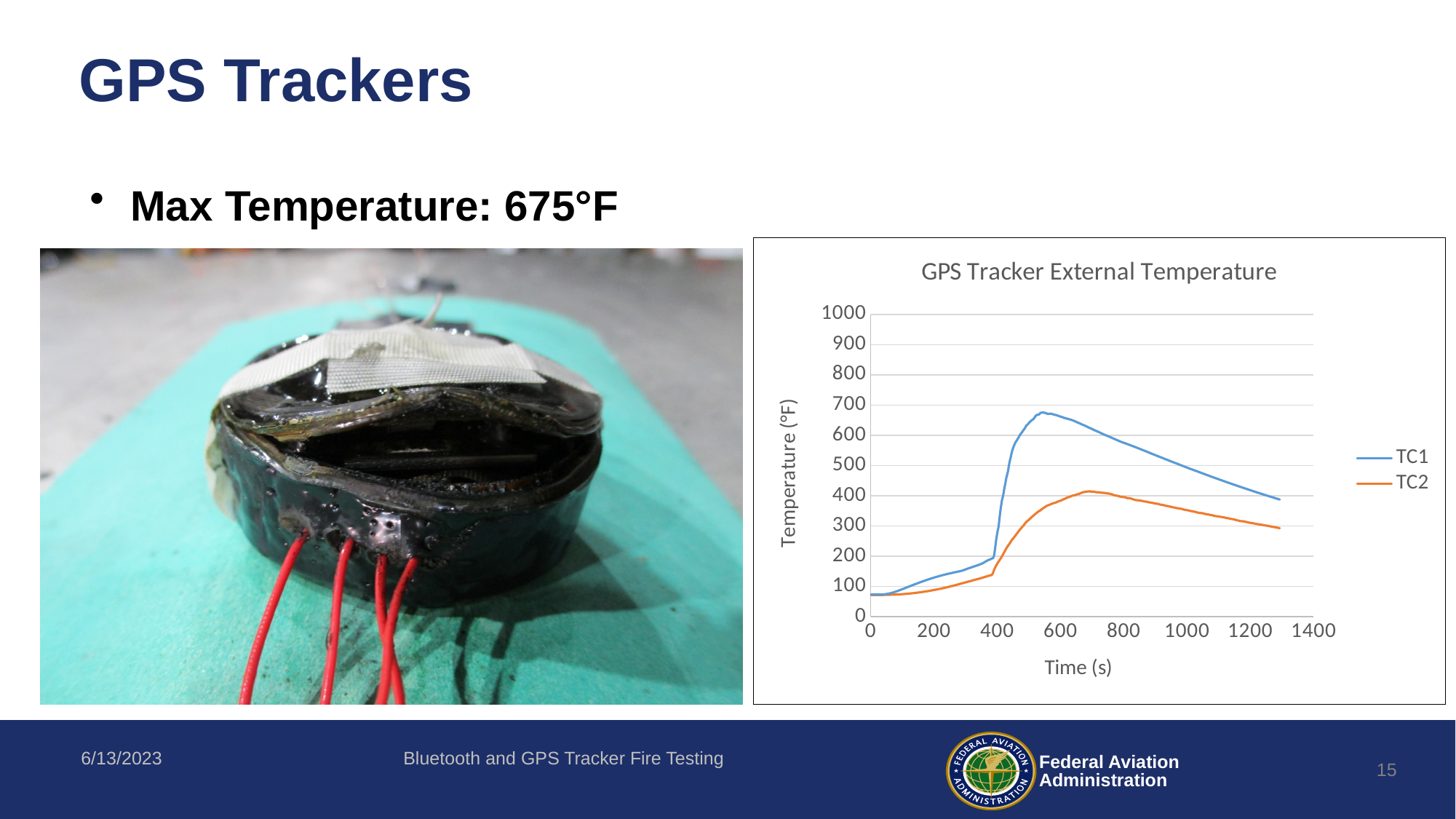
Is the value of TC1 at 1200 s greater or less than 300? greater What is the label of the vertical axis of the chart? Temperature (°F) What kind of chart is shown on the slide? line chart Is the peak value of TC1 greater or less than 600? greater After its peak near 550 s, does the TC1 line rise or fall as time increases? fall Is the peak value of TC2 greater or less than 500? less What is the title of the chart? GPS Tracker External Temperature At 600 s, which series has the higher temperature, TC1 or TC2? TC1 Which series reaches the higher peak temperature, TC1 or TC2? TC1 How many series does the chart legend list? 2